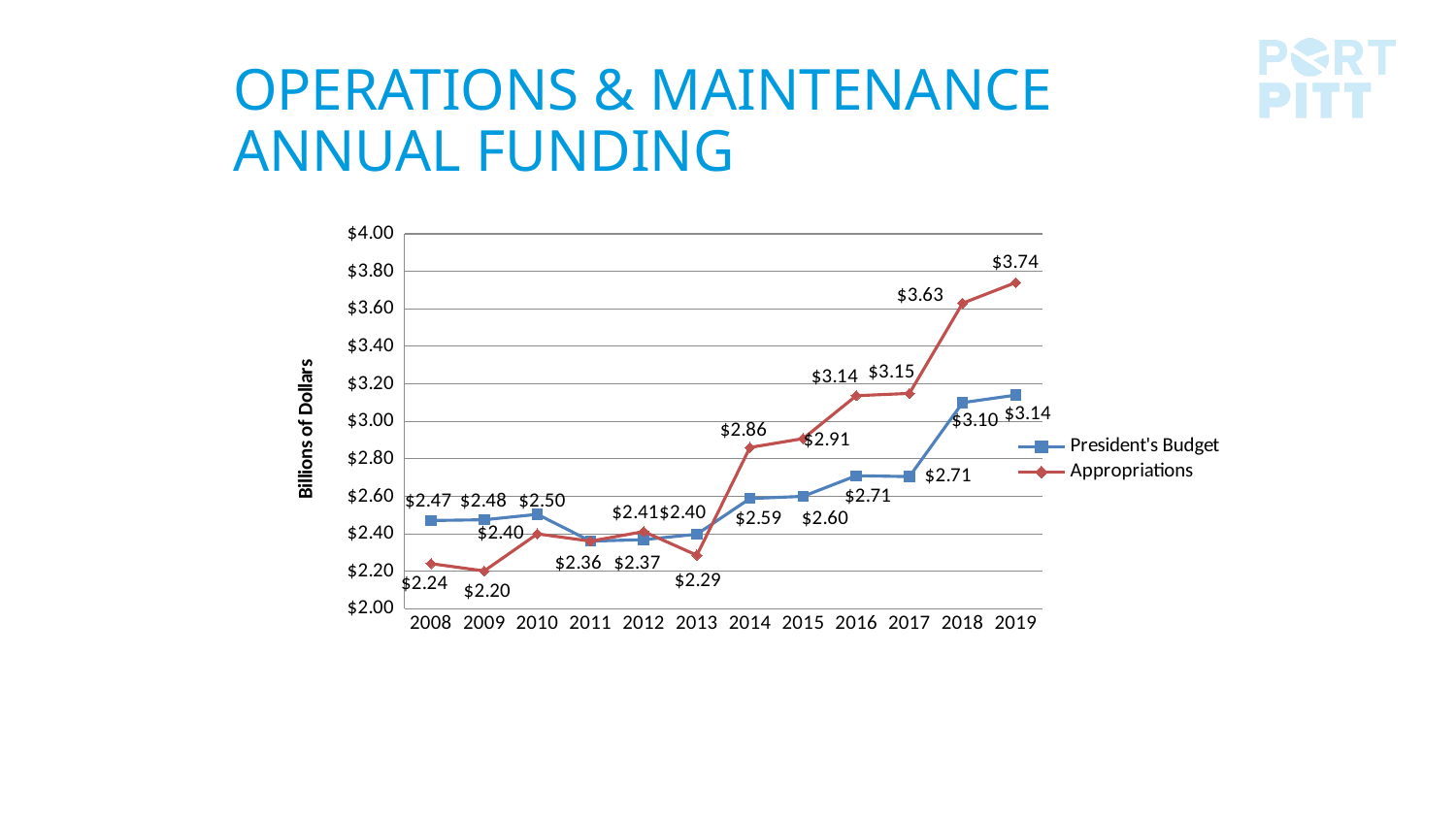
What is the Appropriations value for 2019? $3.74 What is the label on the y axis? Billions of Dollars How many series does the legend list? 2 Is the Appropriations value for 2018 greater or less than $3.40? greater How many years are plotted along the x axis? 12 In which year is the Appropriations value lowest? 2009 In 2008, which series has the larger value, President's Budget or Appropriations? President's Budget Do the Appropriations values rise or fall from 2013 to 2019? rise What is the difference between Appropriations and President's Budget in 2019? $0.60 What kind of chart is shown on the slide? Line chart What is the President's Budget value for 2018? $3.10 In which year is the Appropriations value highest? 2019